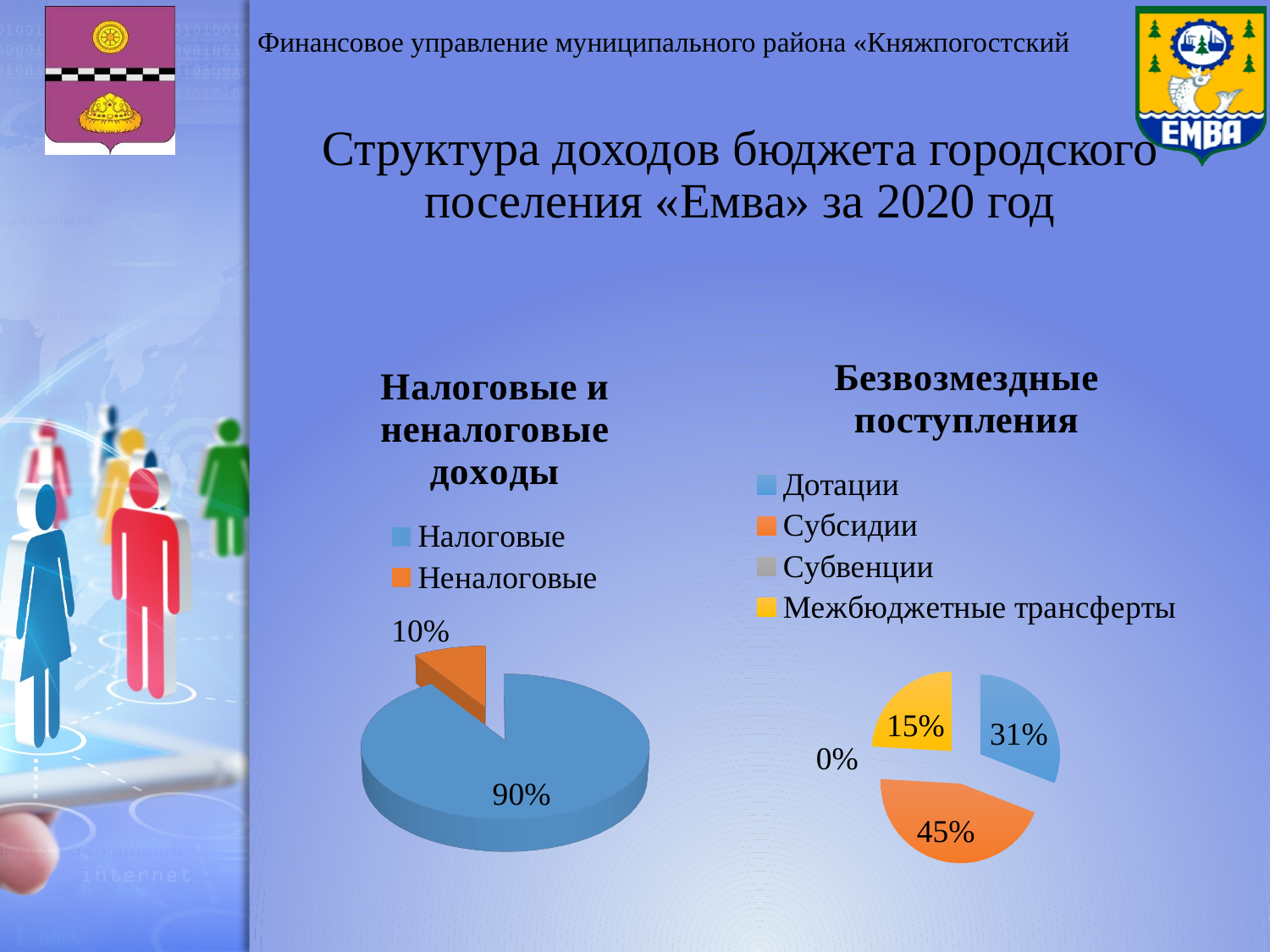
In the chart titled «Безвозмездные поступления», which is larger: Дотации or Межбюджетные трансферты? Дотации In the chart titled «Налоговые и неналоговые доходы», which category has the larger share? Налоговые In the chart titled «Безвозмездные поступления», how many categories does the legend list? 4 In the chart titled «Безвозмездные поступления», what share is shown for Межбюджетные трансферты? 15% In the chart titled «Безвозмездные поступления», which category has the largest share? Субсидии In the chart titled «Налоговые и неналоговые доходы», what share is shown for Налоговые? 90% In the chart titled «Налоговые и неналоговые доходы», what is the difference in percentage points between Налоговые and Неналоговые? 80 What kind of chart is the one titled «Налоговые и неналоговые доходы»? Pie chart In the chart titled «Безвозмездные поступления», what share is shown for Дотации? 31% In the chart titled «Безвозмездные поступления», which category has the smallest share? Субвенции In the chart titled «Безвозмездные поступления», what share is shown for Субсидии? 45% In the chart titled «Налоговые и неналоговые доходы», what share is shown for Неналоговые? 10%